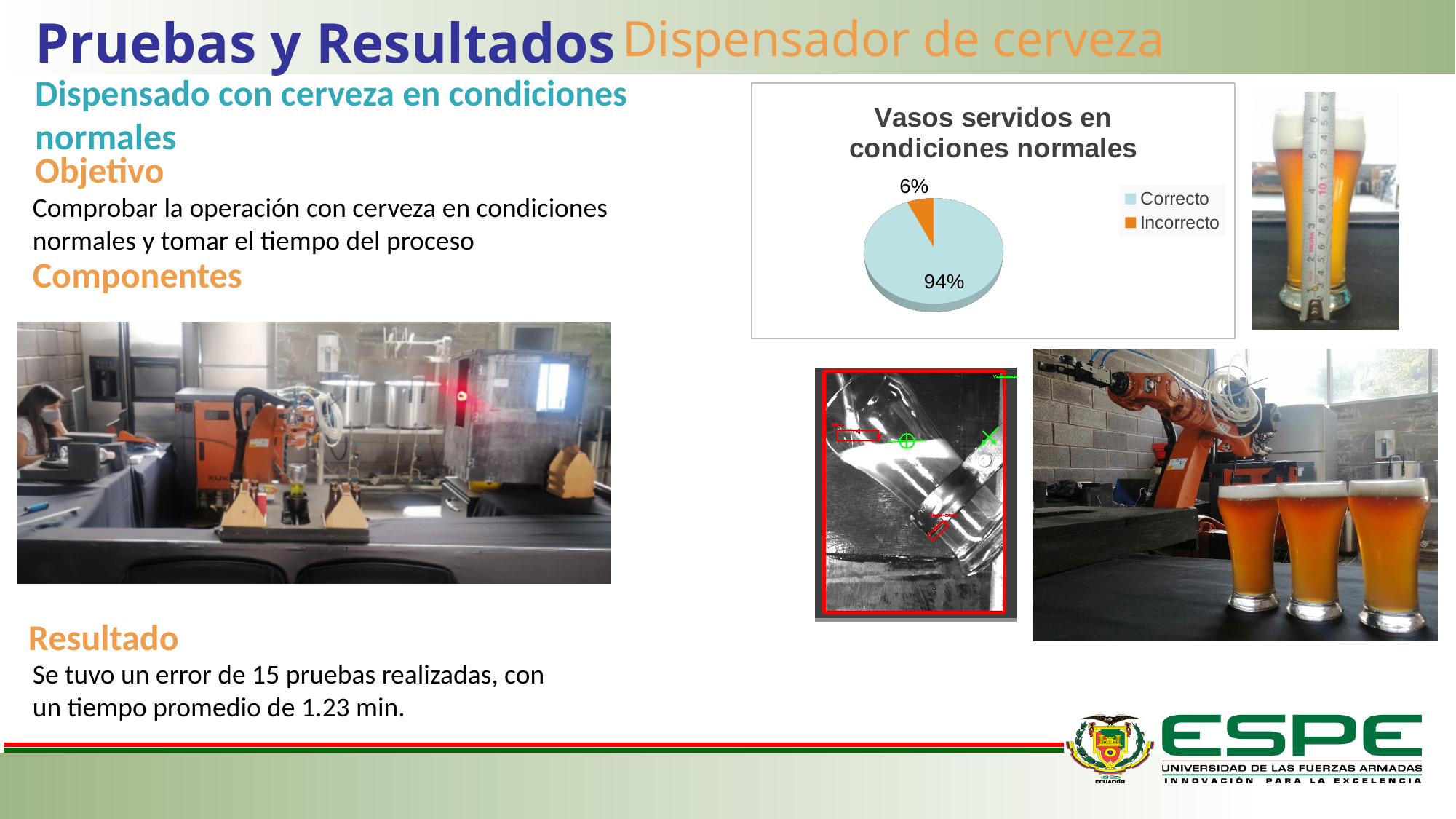
How many slices does the pie chart have? 2 What is the difference in percentage points between Correcto and Incorrecto? 88 Which category has the smallest share of the pie? Incorrecto What percentage of the pie is labelled Correcto? 94% What percentage of the pie is labelled Incorrecto? 6% What kind of chart is shown on the slide? pie chart Which is larger, the share for Correcto or the share for Incorrecto? Correcto What is the share of the pie for Correcto? 94% What is the title of the chart? Vasos servidos en condiciones normales What colour represents Incorrecto in the pie chart? orange How many categories does the legend list? 2 Which category has the largest share of the pie? Correcto